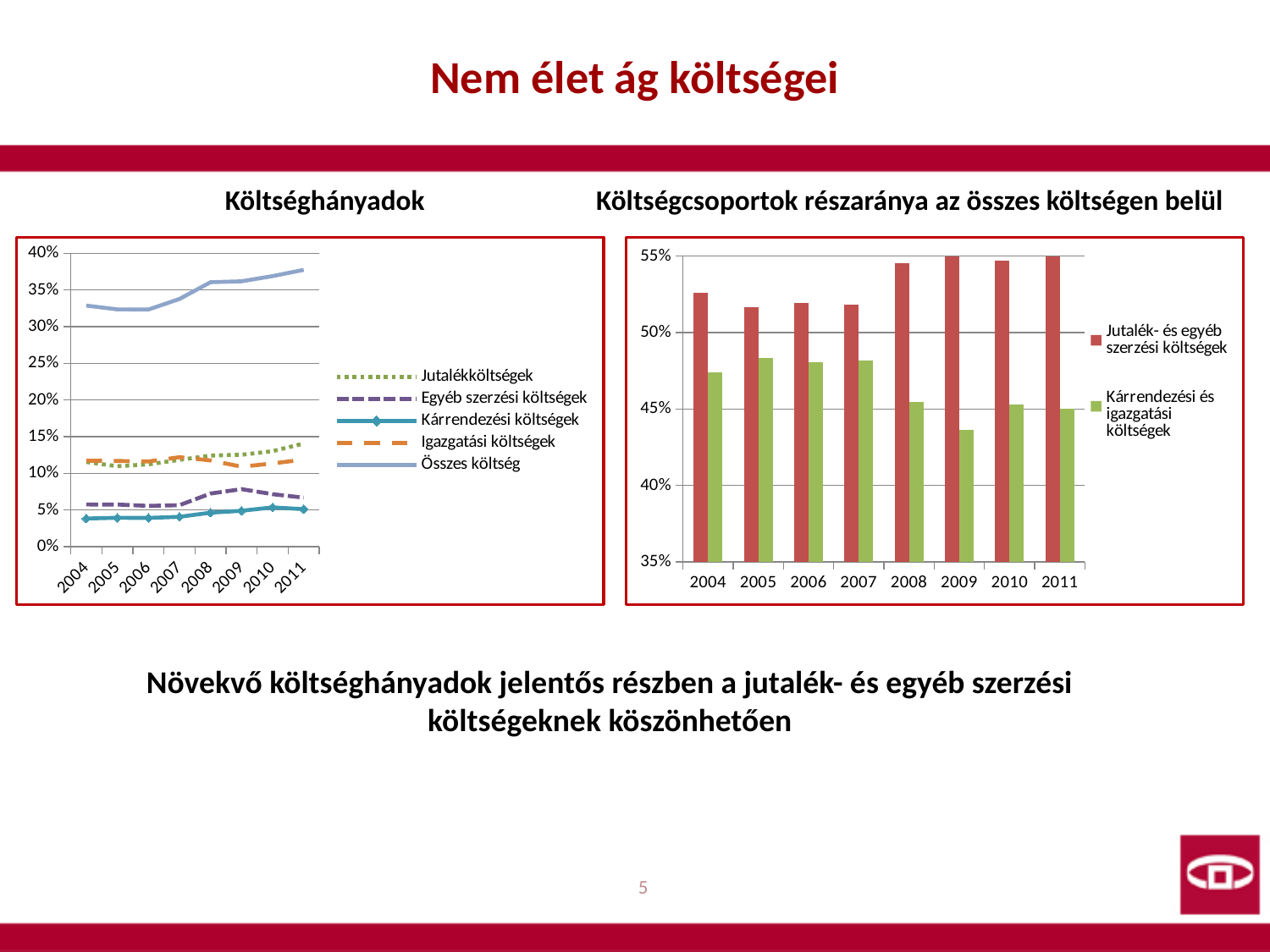
In the "Költségcsoportok részaránya az összes költségen belül" chart, what colour are the Kárrendezési és igazgatási költségek bars? green What kind of chart is the left chart titled "Költséghányadok"? line chart In the "Költséghányadok" chart, is the value of Összes költség in 2011 greater or less than 35%? greater In the "Költségcsoportok részaránya az összes költségen belül" chart, which series has the larger value in 2004? Jutalék- és egyéb szerzési költségek In the "Költséghányadok" chart, is the value of Kárrendezési költségek in 2004 greater or less than 5%? less In the "Költségcsoportok részaránya az összes költségen belül" chart, in which year is the Kárrendezési és igazgatási költségek bar lowest? 2009 In the "Költségcsoportok részaránya az összes költségen belül" chart, how many series does the legend list? 2 In the "Költséghányadok" chart, does the Összes költség series rise or fall from 2004 to 2011? rise What kind of chart is the right chart titled "Költségcsoportok részaránya az összes költségen belül"? bar chart In the "Költséghányadok" chart, how many series does the legend list? 5 In the "Költségcsoportok részaránya az összes költségen belül" chart, how many years are shown on the x axis? 8 In the "Költségcsoportok részaránya az összes költségen belül" chart, is the value of Kárrendezési és igazgatási költségek in 2009 greater or less than 45%? less